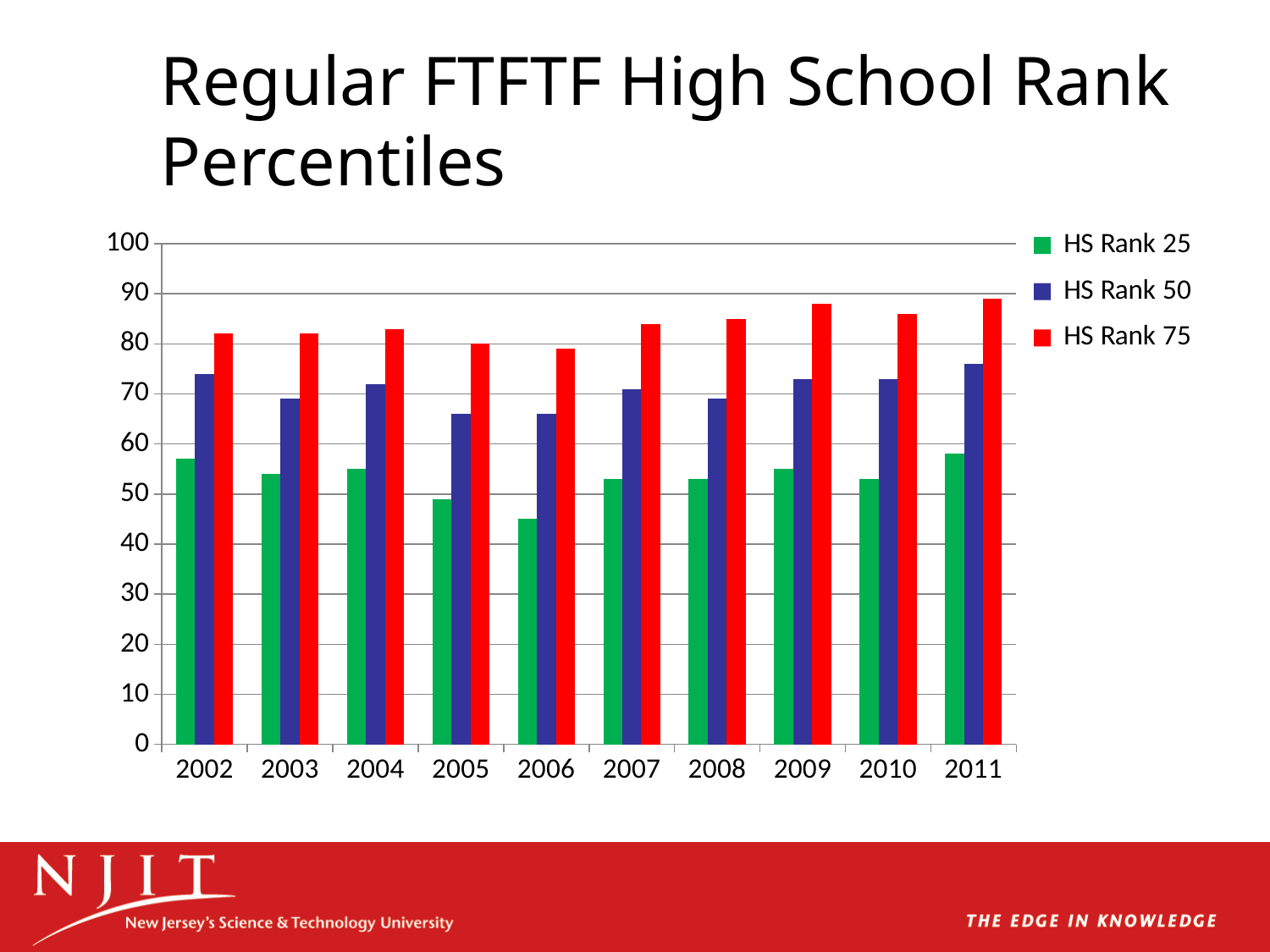
Which colour represents HS Rank 75 in the legend? red Which is larger, the HS Rank 75 value for 2011 or for 2005? 2011 Is the HS Rank 25 value for 2002 greater or less than 50? greater Do the HS Rank 75 values rise or fall from 2006 to 2011? rise What kind of chart is shown on the slide? bar chart Is the HS Rank 50 value for 2005 greater or less than 70? less Is the HS Rank 25 value for 2006 greater or less than 50? less What is the title of the chart? Regular FTFTF High School Rank Percentiles How many series does the legend list? 3 How many years are shown on the x axis? 10 In which year is the HS Rank 25 value lowest? 2006